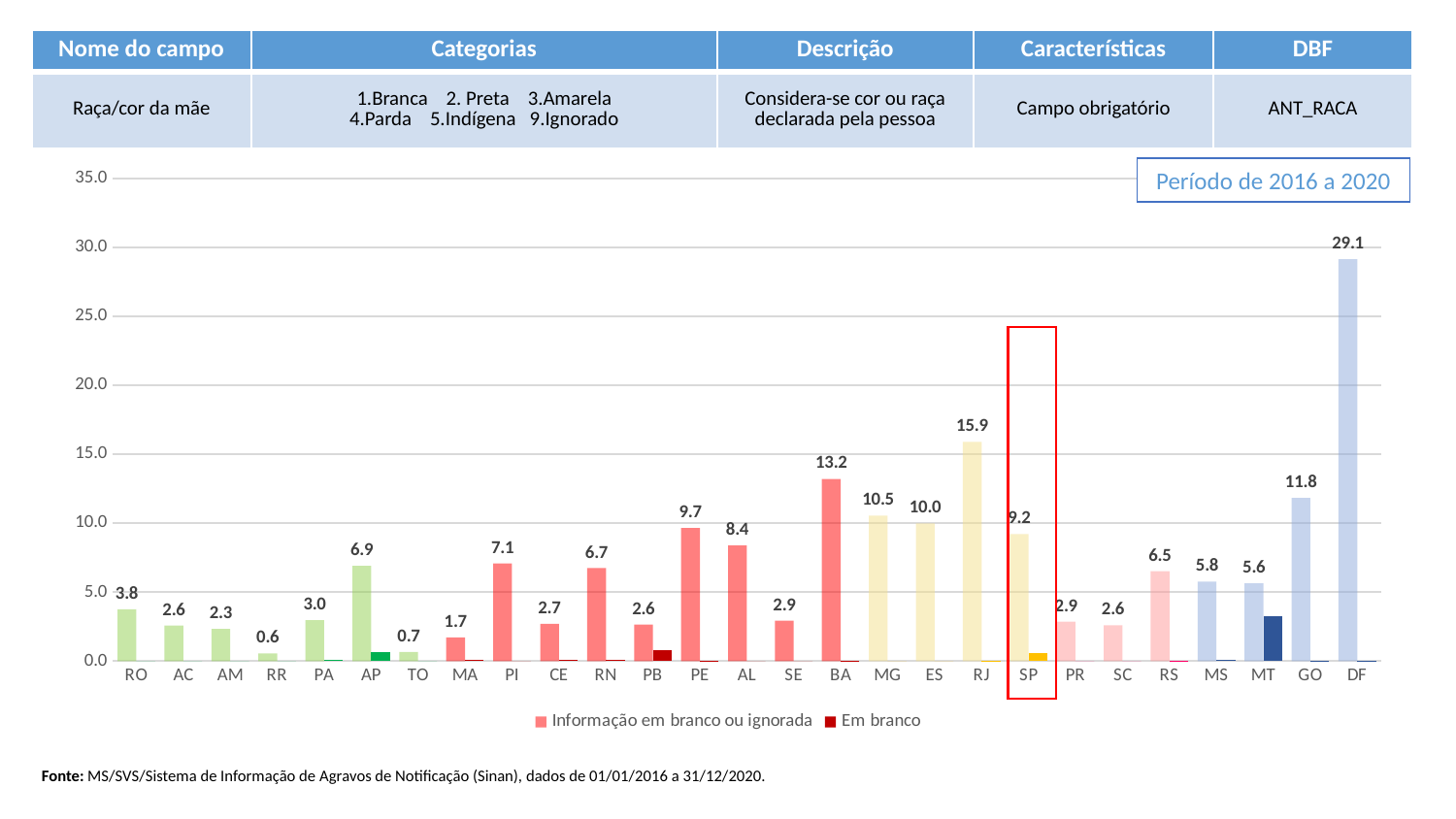
How many series does the legend list? 2 How many states are shown on the x axis of the chart? 27 Which state has the lowest labelled value in the chart? RR What is the value for BA in the chart? 13.2 What is the value shown for SP in the chart? 9.2 What kind of chart is shown on the slide? bar chart Which state is highlighted with a red box in the chart? SP What is the value for DF in the chart? 29.1 Is the 'Em branco' bar for MT greater or less than 5.0? less Which state has the highest value in the chart? DF Which has a larger value, PE or AL? PE What is the difference between the values for RJ and SP? 6.7